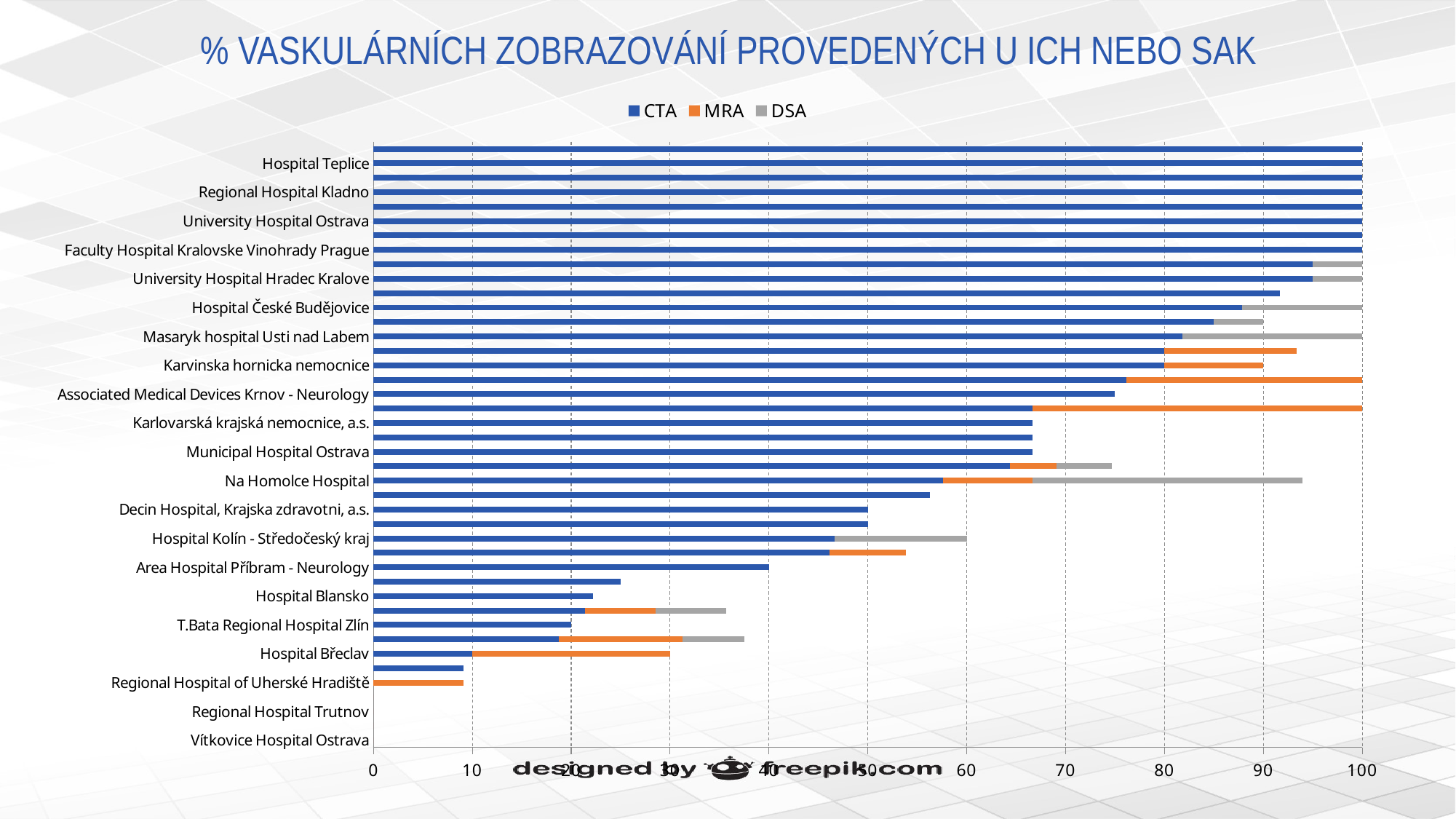
What kind of chart is shown on the slide? bar chart Is the CTA value for Na Homolce Hospital greater or less than 50? greater What is the CTA value for Hospital Teplice? 100 How many series does the legend list? 3 Is the CTA value for Hospital Blansko greater or less than 30? less Is the CTA value for Karlovarská krajská nemocnice, a.s. greater or less than 60? greater What is the title of the chart? % VASKULÁRNÍCH ZOBRAZOVÁNÍ PROVEDENÝCH U ICH NEBO SAK Which has the larger CTA value, Hospital Teplice or Hospital Blansko? Hospital Teplice What are the three series named in the legend? CTA, MRA, DSA